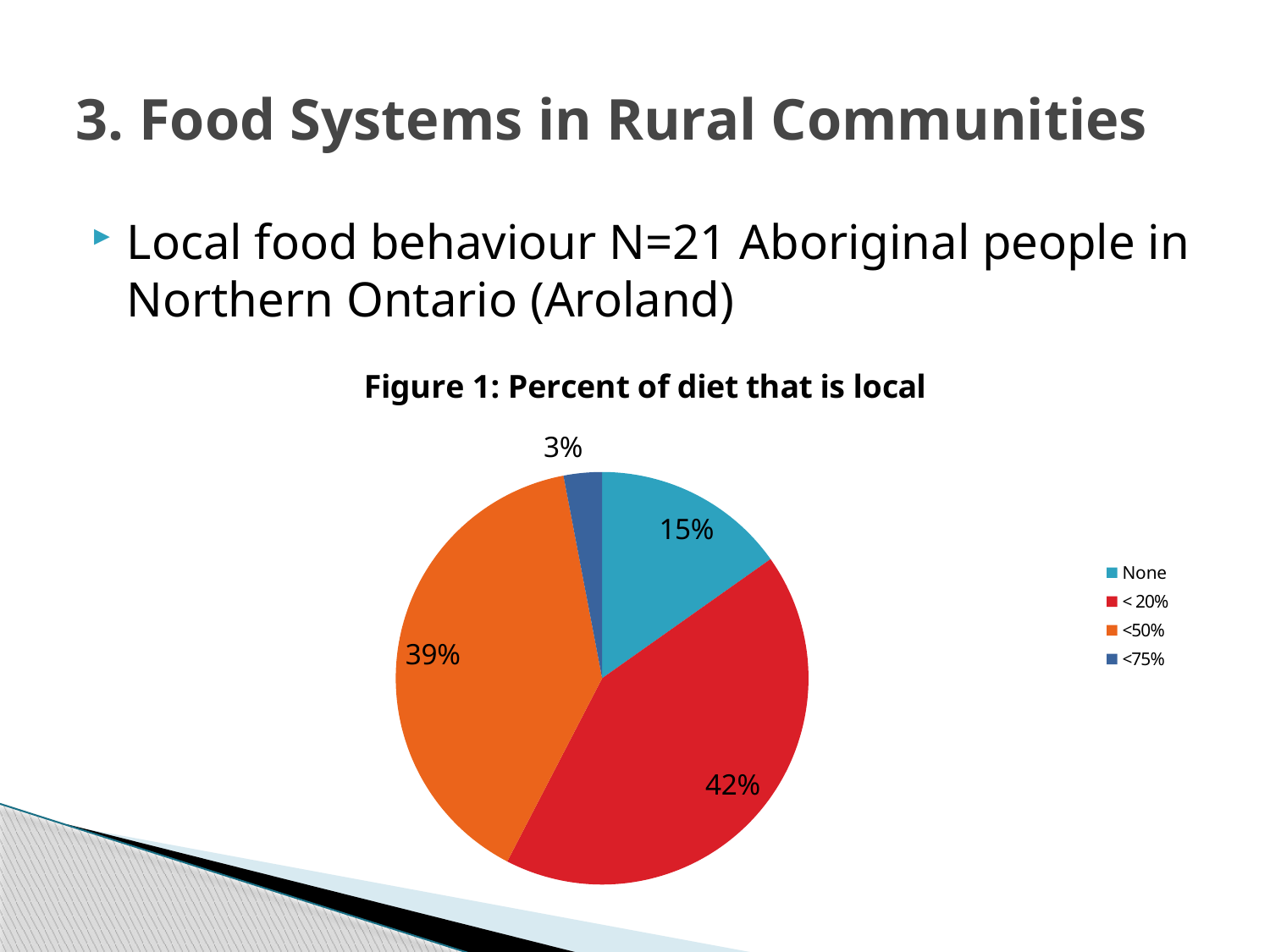
What share of the pie is labelled "< 20%"? 42% What is the difference in percentage points between the "< 20%" slice and the "<50%" slice? 3 Which slice is larger, "None" or "<75%"? None Which category has the largest slice of the pie? < 20% What colour is the slice for "<50%"? orange What is the title of the chart? Figure 1: Percent of diet that is local What share of the pie is labelled "<75%"? 3% Which category has the smallest slice of the pie? <75% What type of chart is shown on the slide? pie chart What share of the pie is labelled "None"? 15% How many categories does the legend list? 4